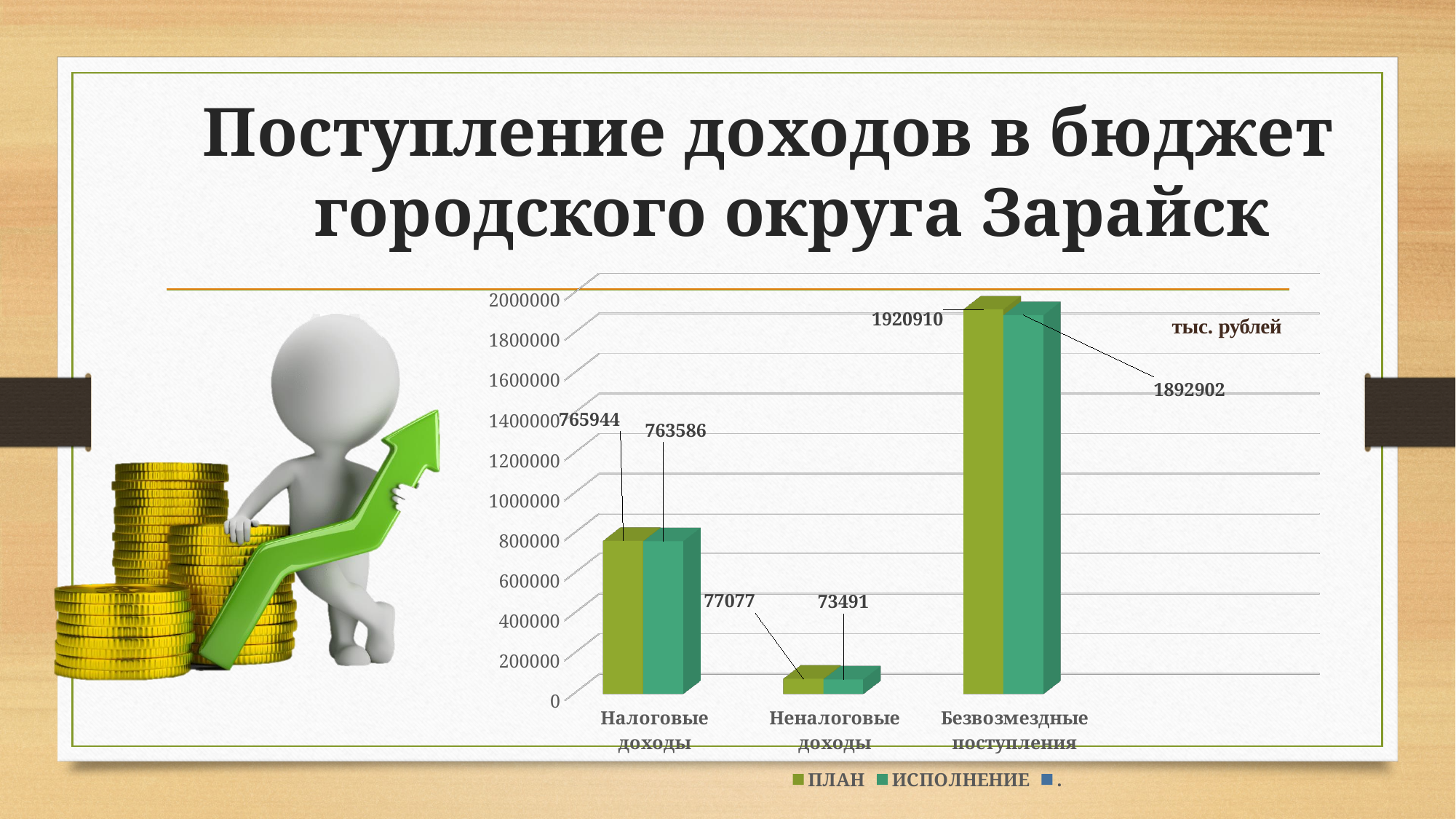
Which category has the lowest ИСПОЛНЕНИЕ value? Неналоговые доходы What is the ПЛАН value for Налоговые доходы? 765944 Which is larger for Налоговые доходы, the ПЛАН value or the ИСПОЛНЕНИЕ value? ПЛАН Which category has the highest ПЛАН value? Безвозмездные поступления What is the ИСПОЛНЕНИЕ value for Безвозмездные поступления? 1892902 What is the ИСПОЛНЕНИЕ value for Неналоговые доходы? 73491 How many categories are shown on the x axis of the chart? 3 What is the difference between the ПЛАН and ИСПОЛНЕНИЕ values for Безвозмездные поступления? 28008 What is the difference between the ПЛАН and ИСПОЛНЕНИЕ values for Неналоговые доходы? 3586 What unit is indicated on the chart? тыс. рублей What is the ПЛАН value for Безвозмездные поступления? 1920910 What kind of chart is shown on the slide? Bar chart